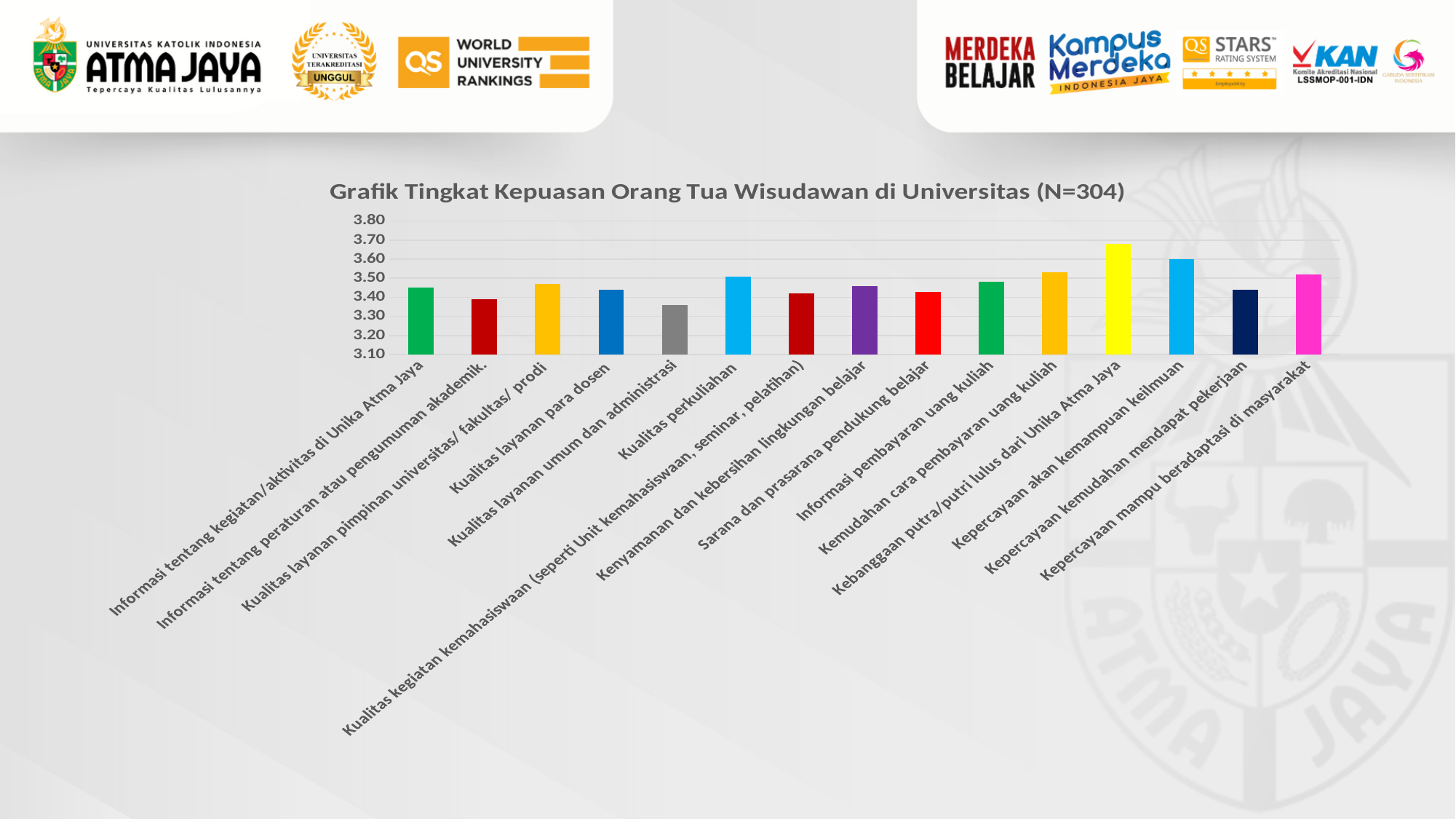
Is the value for Informasi tentang kegiatan/aktivitas di Unika Atma Jaya greater or less than 3.50? less Which is larger: the value for Kepercayaan kemudahan mendapat pekerjaan or the value for Kepercayaan mampu beradaptasi di masyarakat? Kepercayaan mampu beradaptasi di masyarakat Which category has the highest value? Kebanggaan putra/putri lulus dari Unika Atma Jaya Which is larger: the value for Kebanggaan putra/putri lulus dari Unika Atma Jaya or the value for Kepercayaan akan kemampuan keilmuan? Kebanggaan putra/putri lulus dari Unika Atma Jaya Is the value for Kenyamanan dan kebersihan lingkungan belajar greater or less than 3.50? less Is the value for Kebanggaan putra/putri lulus dari Unika Atma Jaya greater or less than 3.60? greater How many categories are plotted on the chart? 15 What kind of chart is shown on the slide? bar chart What colour is the bar for Kebanggaan putra/putri lulus dari Unika Atma Jaya? yellow What is the title of the chart? Grafik Tingkat Kepuasan Orang Tua Wisudawan di Universitas (N=304) Which is larger: the value for Kualitas perkuliahan or the value for Kualitas layanan umum dan administrasi? Kualitas perkuliahan